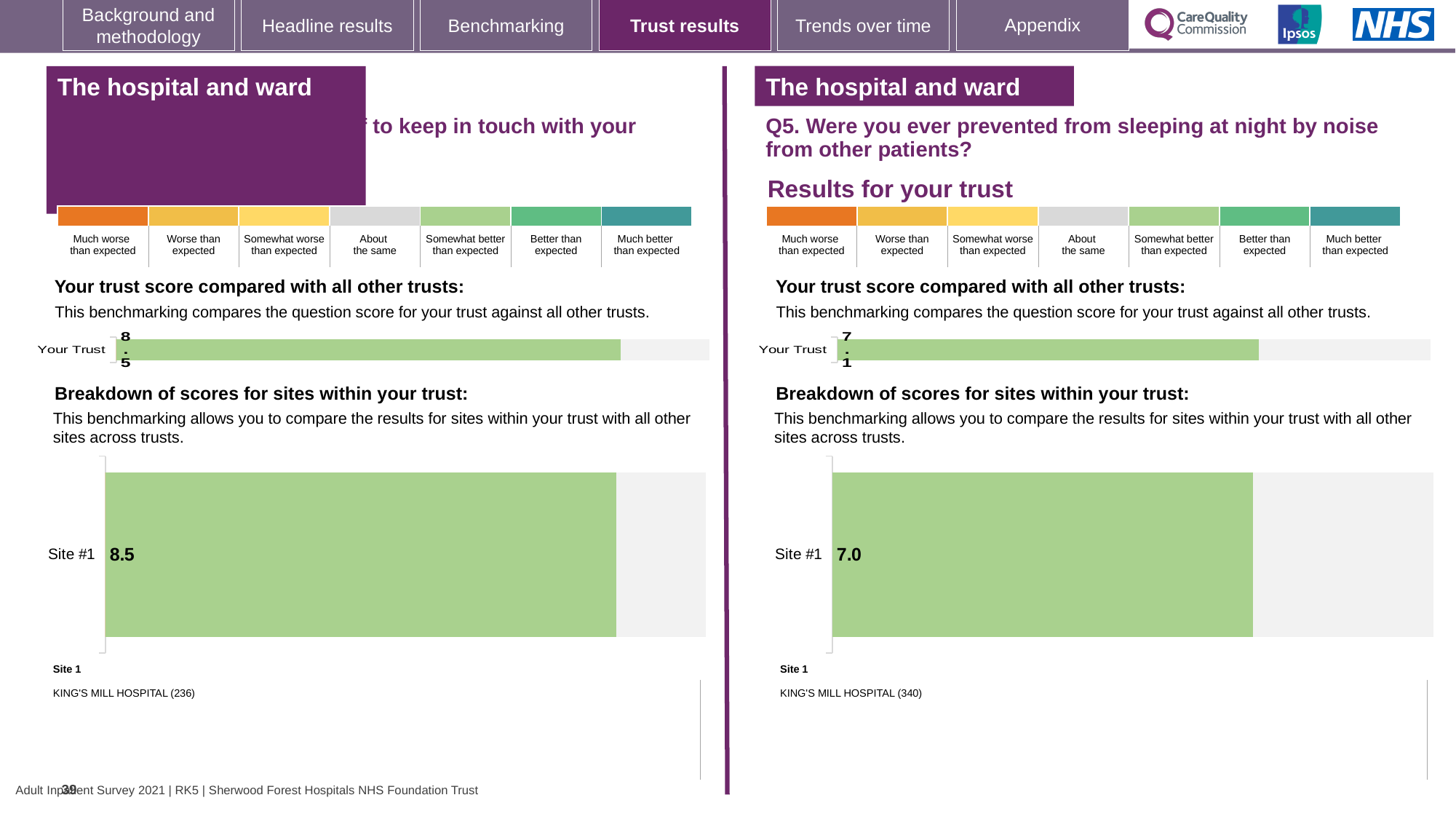
On the left-hand side of the slide, what is the score shown for Site #1 in the 'Breakdown of scores for sites within your trust' chart? 8.5 On the right-hand side of the slide (Q5), what is the score shown for Site #1 in the 'Breakdown of scores for sites within your trust' chart? 7.0 On the left-hand side of the slide, which hospital is listed as Site 1 below the breakdown chart? KING'S MILL HOSPITAL (236) On the right-hand side of the slide (Q5), which hospital is listed as Site 1 below the breakdown chart? KING'S MILL HOSPITAL (340) Which is larger: the Site #1 score in the left-hand breakdown chart or the Site #1 score in the right-hand (Q5) breakdown chart? Left-hand chart (8.5) On the left-hand side of the slide, what is the score shown for Your Trust in the 'Your trust score compared with all other trusts' chart? 8.5 On the right-hand side of the slide (Q5), what is the score shown for Your Trust in the 'Your trust score compared with all other trusts' chart? 7.1 How many sites are shown in the 'Breakdown of scores for sites within your trust' chart on the right-hand side of the slide (Q5)? 1 What is the difference between the Site #1 score in the left-hand breakdown chart (8.5) and the Site #1 score in the right-hand Q5 breakdown chart (7.0)? 1.5 On the right-hand side of the slide (Q5), what is the difference between the Your Trust score (7.1) and the Site #1 score (7.0)? 0.1 What colour is the Site #1 bar in the 'Breakdown of scores for sites within your trust' chart on the right-hand side of the slide (Q5)? Light green What type of chart is used to show the Site #1 score in the 'Breakdown of scores for sites within your trust' section on the right-hand side of the slide? Bar chart